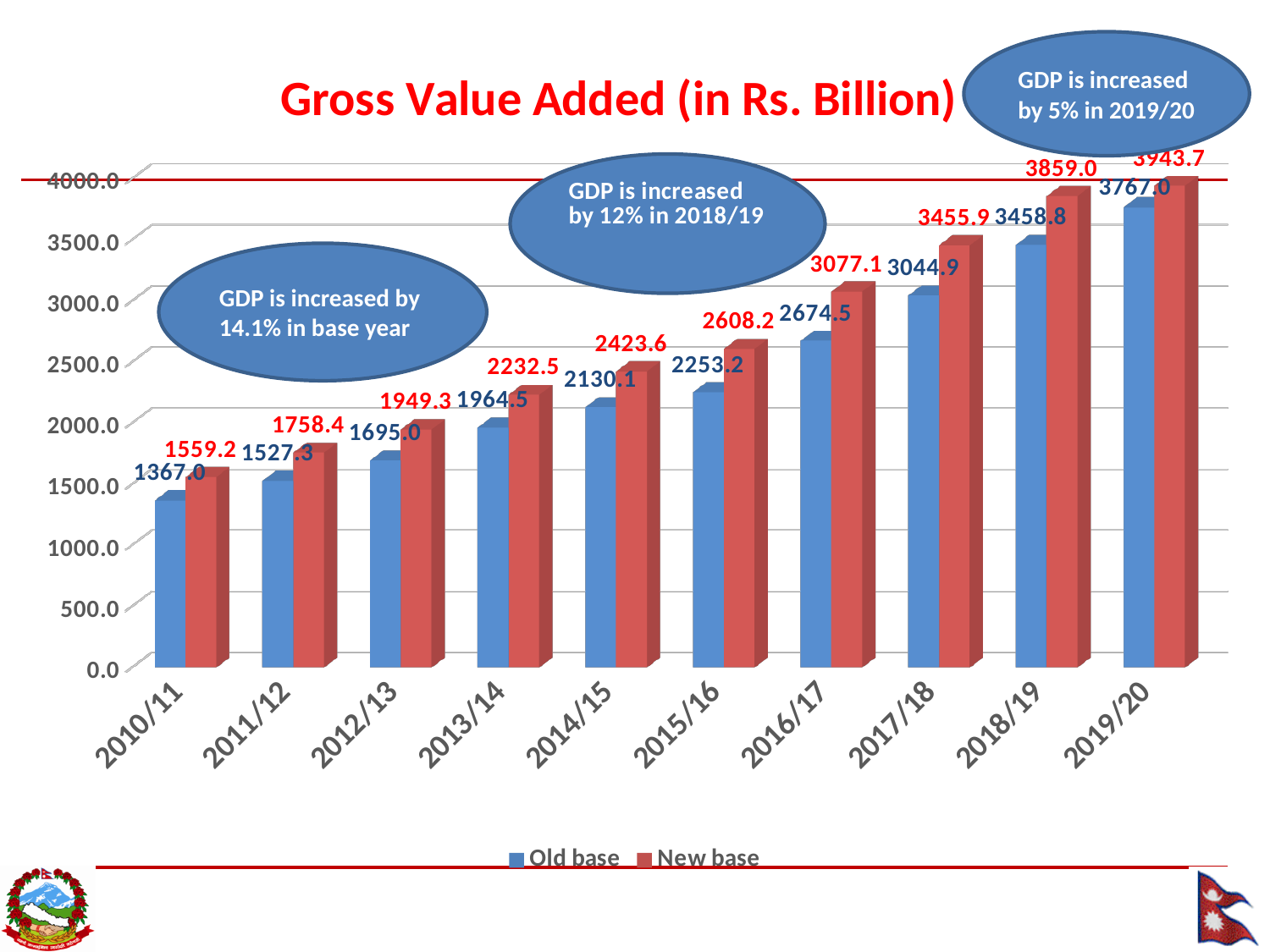
Which year has the highest New base value? 2019/20 What is the New base value for 2018/19? 3859.0 Which year has the lowest Old base value? 2010/11 Which is larger for 2016/17, the Old base value or the New base value? New base What is the Old base value for 2010/11? 1367.0 What is the New base value for 2014/15? 2423.6 What is the difference between the New base and Old base values for 2013/14? 268.0 What is the Old base value for 2017/18? 3044.9 How many series does the legend list? 2 How many years are shown on the x axis? 10 What kind of chart is shown on the slide? Bar chart Do the Old base values rise or fall from 2010/11 to 2019/20? Rise